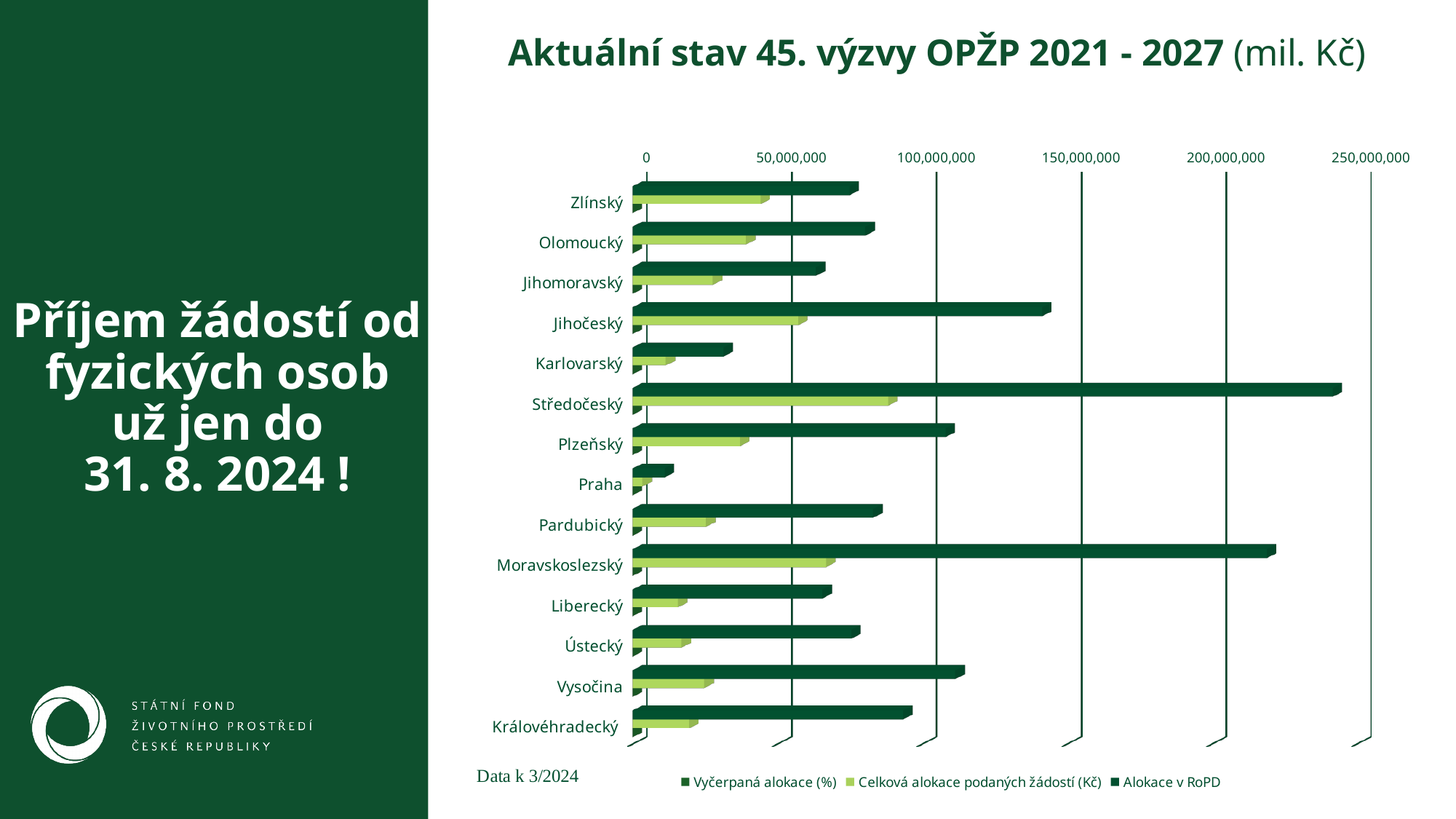
Is the longest bar for Jihočeský greater or less than 100,000,000? greater How many regions (categories) are listed on the vertical axis of the chart? 14 Which region has the longest bar overall in the chart? Středočeský What kind of chart is shown on the slide? bar chart Is the light green bar (Celková alokace podaných žádostí) for Zlínský greater or less than 50,000,000? less How many series does the chart legend list? 3 Which region has the shortest longest-bar (smallest top bar) in the chart? Praha Is the longest bar for Karlovarský greater or less than 50,000,000? less What is the title of the chart? Aktuální stav 45. výzvy OPŽP 2021 - 2027 (mil. Kč) Which region has the longer top bar, Jihočeský or Olomoucký? Jihočeský Which region has the longest light green bar (Celková alokace podaných žádostí)? Středočeský